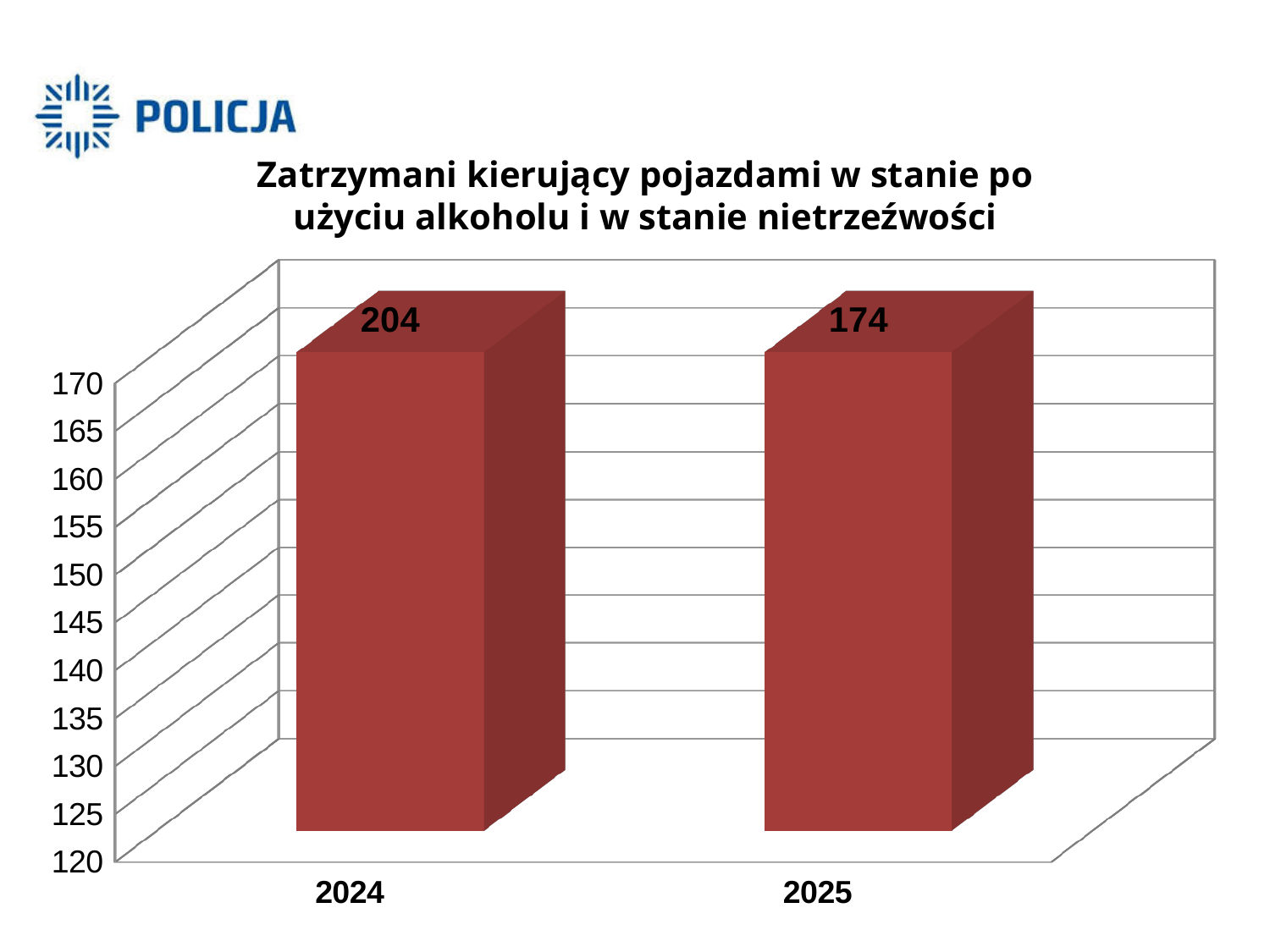
Which is larger, the value for 2024 or the value for 2025? 2024 What kind of chart is shown on the slide? bar chart Is the value for 2025 greater or less than 150? greater Which year has the lowest value? 2025 Which year has the highest value? 2024 What colour are the bars in the chart? red What is the title of the chart? Zatrzymani kierujący pojazdami w stanie po użyciu alkoholu i w stanie nietrzeźwości How many years are shown on the x axis? 2 What is the difference between the values for 2024 and 2025? 30 Do the values rise or fall from 2024 to 2025? fall What is the value for 2024? 204 What is the value for 2025? 174